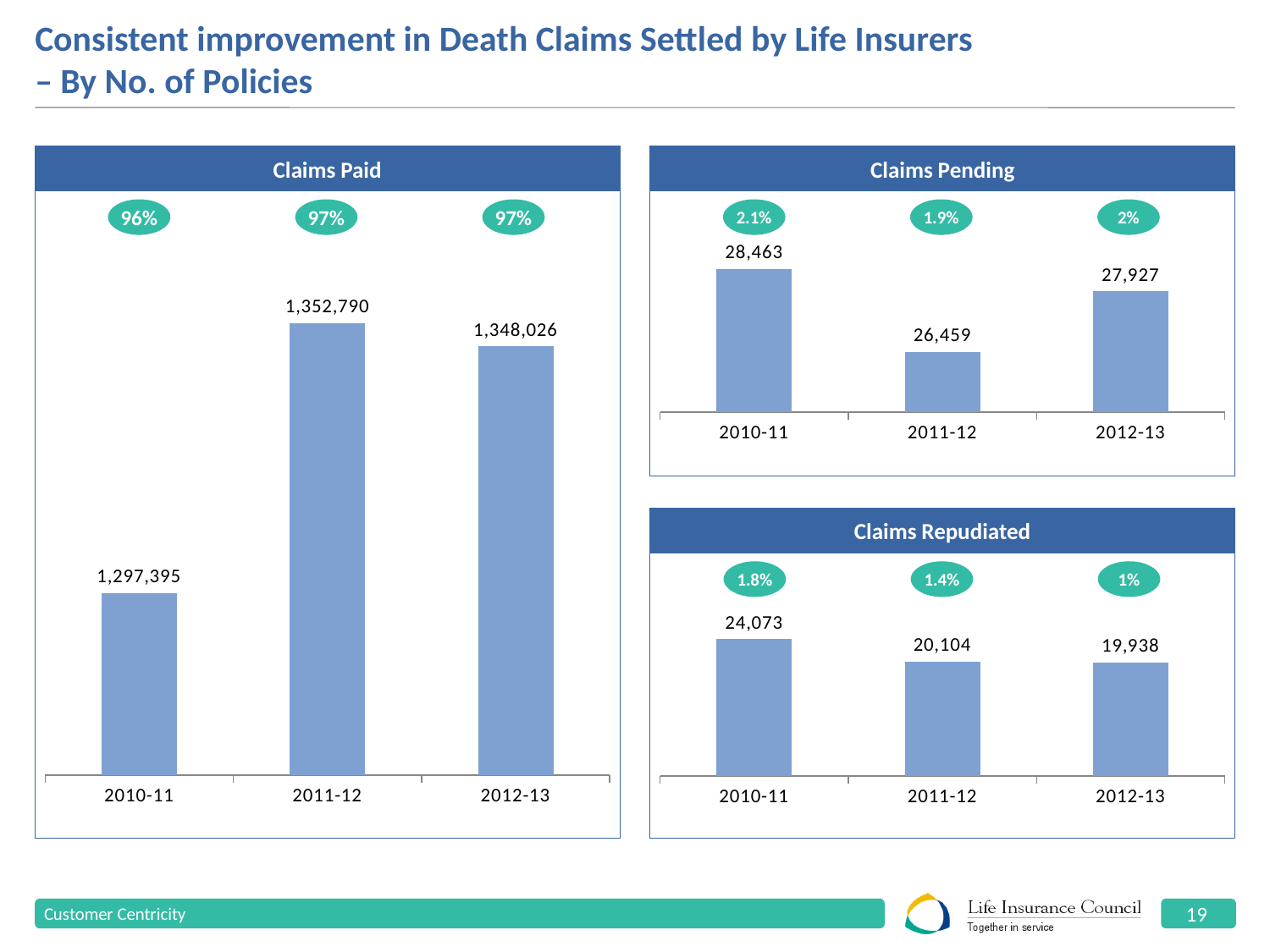
In the Claims Repudiated chart, what is the value for 2011-12? 20,104 In the Claims Repudiated chart, what is the difference between the values for 2010-11 and 2012-13? 4,135 In the Claims Paid chart, what percentage is shown above the 2010-11 bar? 96% In the Claims Paid chart, which year has the lowest number of claims paid? 2010-11 In the Claims Repudiated chart, do the values rise or fall from 2010-11 to 2012-13? fall In the Claims Paid chart, what is the value for 2011-12? 1,352,790 In the Claims Repudiated chart, which is larger, the value for 2010-11 or the value for 2012-13? 2010-11 In the Claims Pending chart, which year has the highest number of claims pending? 2010-11 What kind of chart is the Claims Pending chart? bar chart In the Claims Paid chart, what is the difference between the values for 2011-12 and 2010-11? 55,395 In the Claims Pending chart, what is the value for 2012-13? 27,927 In the Claims Pending chart, what is the difference between the values for 2010-11 and 2011-12? 2,004